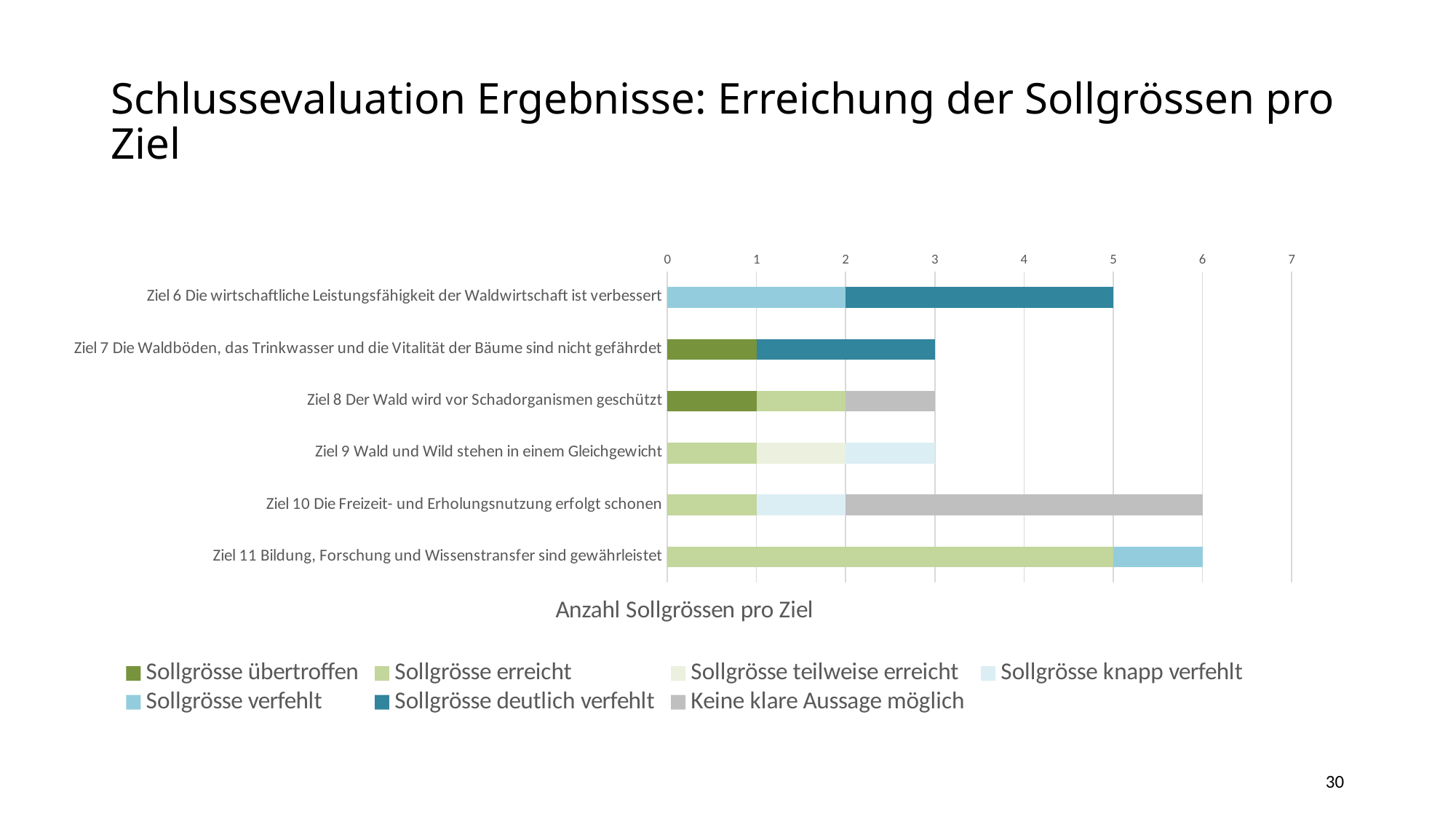
What is the total number of Sollgrössen for Ziel 6? 5 How many Sollgrössen for Ziel 6 fall under 'Sollgrösse deutlich verfehlt'? 3 What is the difference between the total Sollgrössen of Ziel 11 and Ziel 8? 3 What is the total number of Sollgrössen for Ziel 7? 3 Which has more Sollgrössen in total, Ziel 6 or Ziel 7? Ziel 6 What is the total number of Sollgrössen for Ziel 10? 6 What kind of chart is shown on the slide? Stacked bar chart How many Ziele (categories) are shown on the chart? 6 How many series does the legend list? 7 How many Sollgrössen for Ziel 11 fall under 'Sollgrösse erreicht'? 5 How many Sollgrössen for Ziel 10 fall under 'Keine klare Aussage möglich'? 4 What is the x-axis title of the chart? Anzahl Sollgrössen pro Ziel